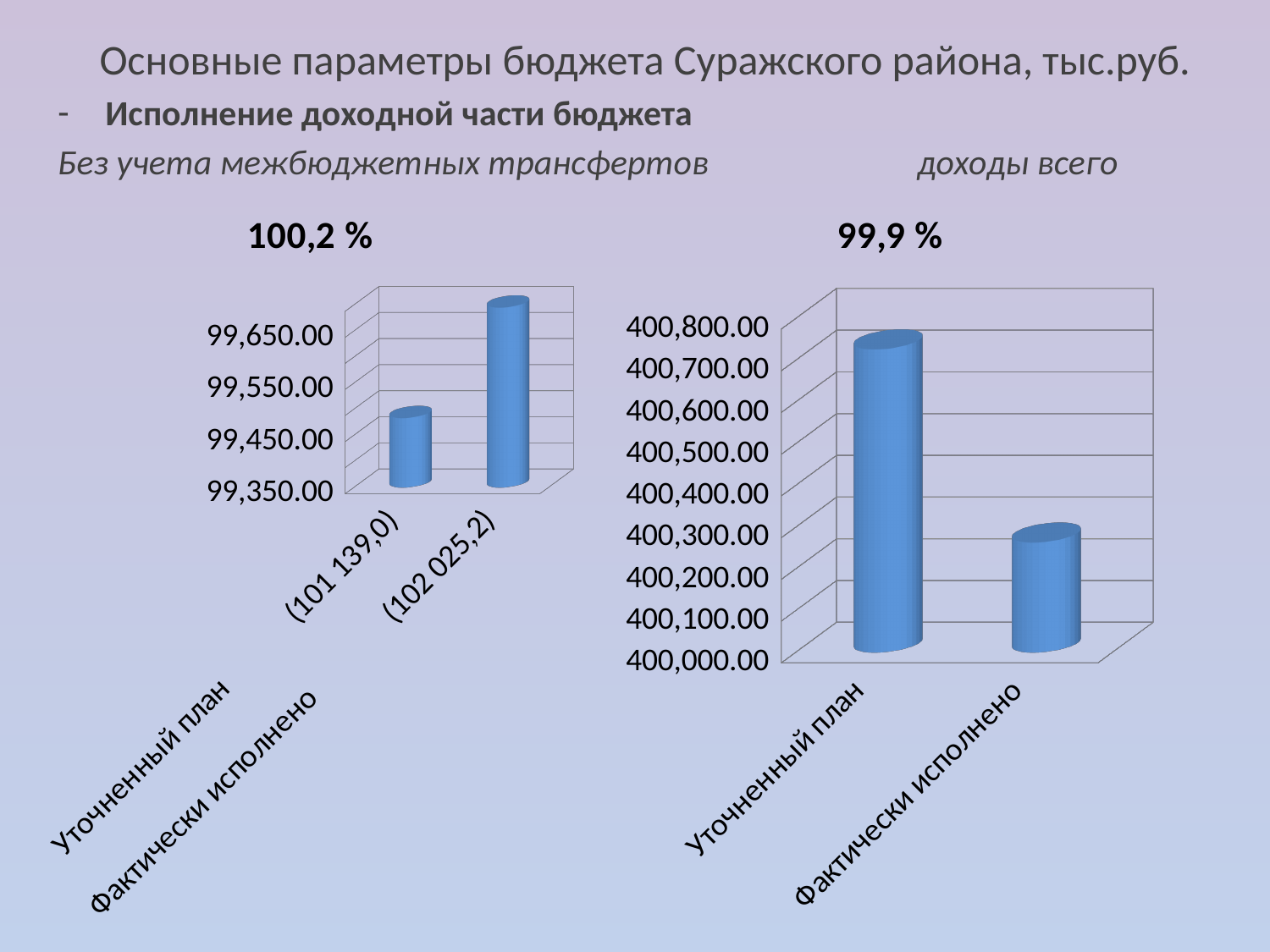
In the left chart (Без учета межбюджетных трансфертов), which category has the higher bar? Фактически исполнено What percentage is shown above the left chart (Без учета межбюджетных трансфертов)? 100,2 % In the left chart (Без учета межбюджетных трансфертов), is the value for Фактически исполнено greater or less than 99,550.00? greater In the left chart (Без учета межбюджетных трансфертов), is the value for Уточненный план greater or less than 99,550.00? less In the right chart (доходы всего), do the bars rise or fall from Уточненный план to Фактически исполнено? Fall In the right chart (доходы всего), is the value for Фактически исполнено greater or less than 400,400.00? less How many bars are plotted in the right chart (доходы всего)? 2 What kind of chart is the left chart (Без учета межбюджетных трансфертов)? Bar chart In the right chart (доходы всего), is the bar for Уточненный план larger or smaller than the bar for Фактически исполнено? Larger In the right chart (доходы всего), which category has the lower bar? Фактически исполнено What percentage is shown above the right chart (доходы всего)? 99,9 %